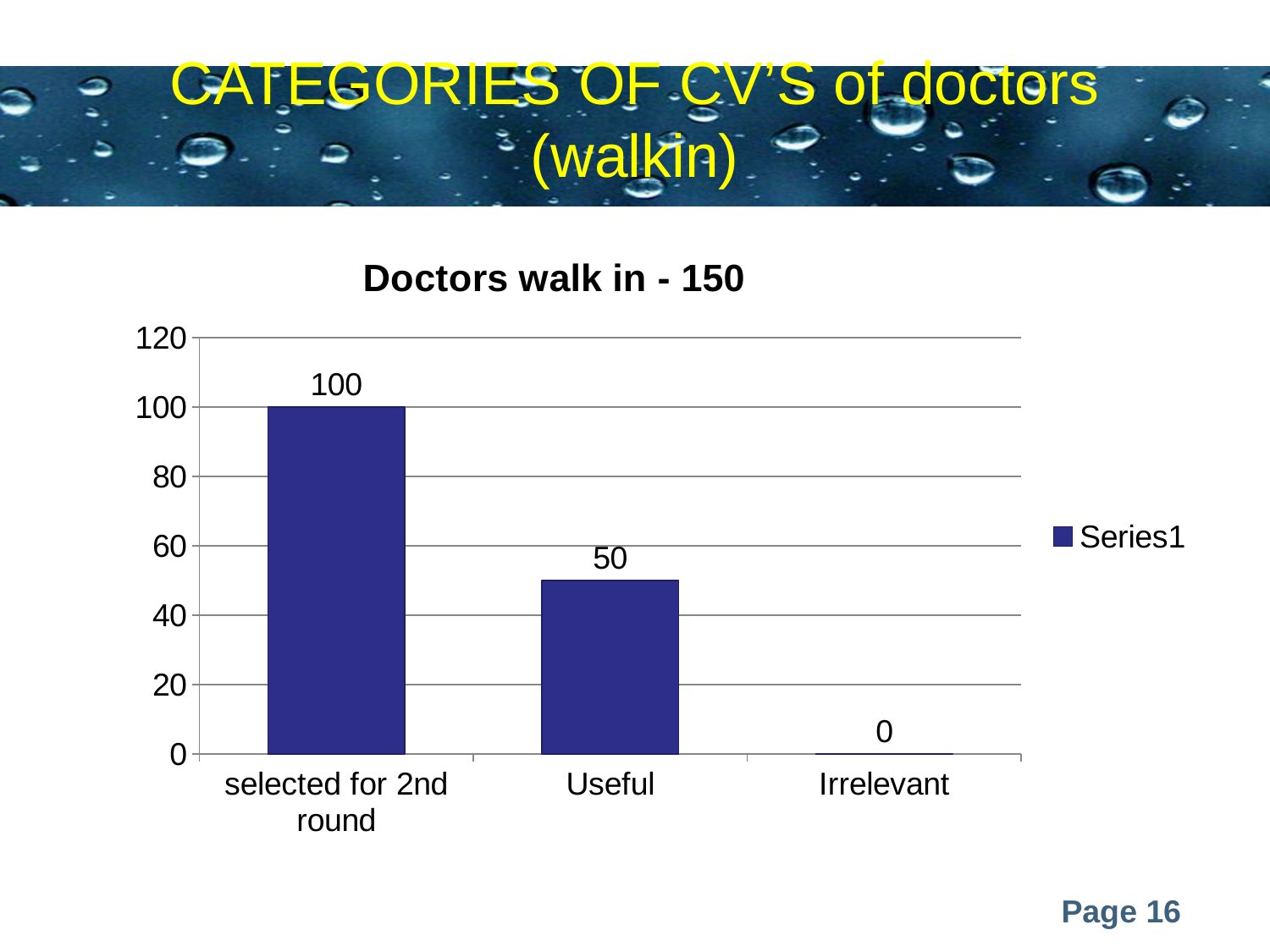
Which category has the highest value? selected for 2nd round What is the difference between the values for 'selected for 2nd round' and 'Useful'? 50 How many series does the legend list? 1 What is the value for 'Irrelevant'? 0 What is the title of the chart? Doctors walk in - 150 What is the value for 'selected for 2nd round'? 100 Which category has the lowest value? Irrelevant What is the value for 'Useful'? 50 Which is larger, the value for 'Useful' or the value for 'Irrelevant'? Useful What kind of chart is shown on the slide? bar chart How many categories are shown on the x axis? 3 Is the value for 'Useful' greater or less than 80? less